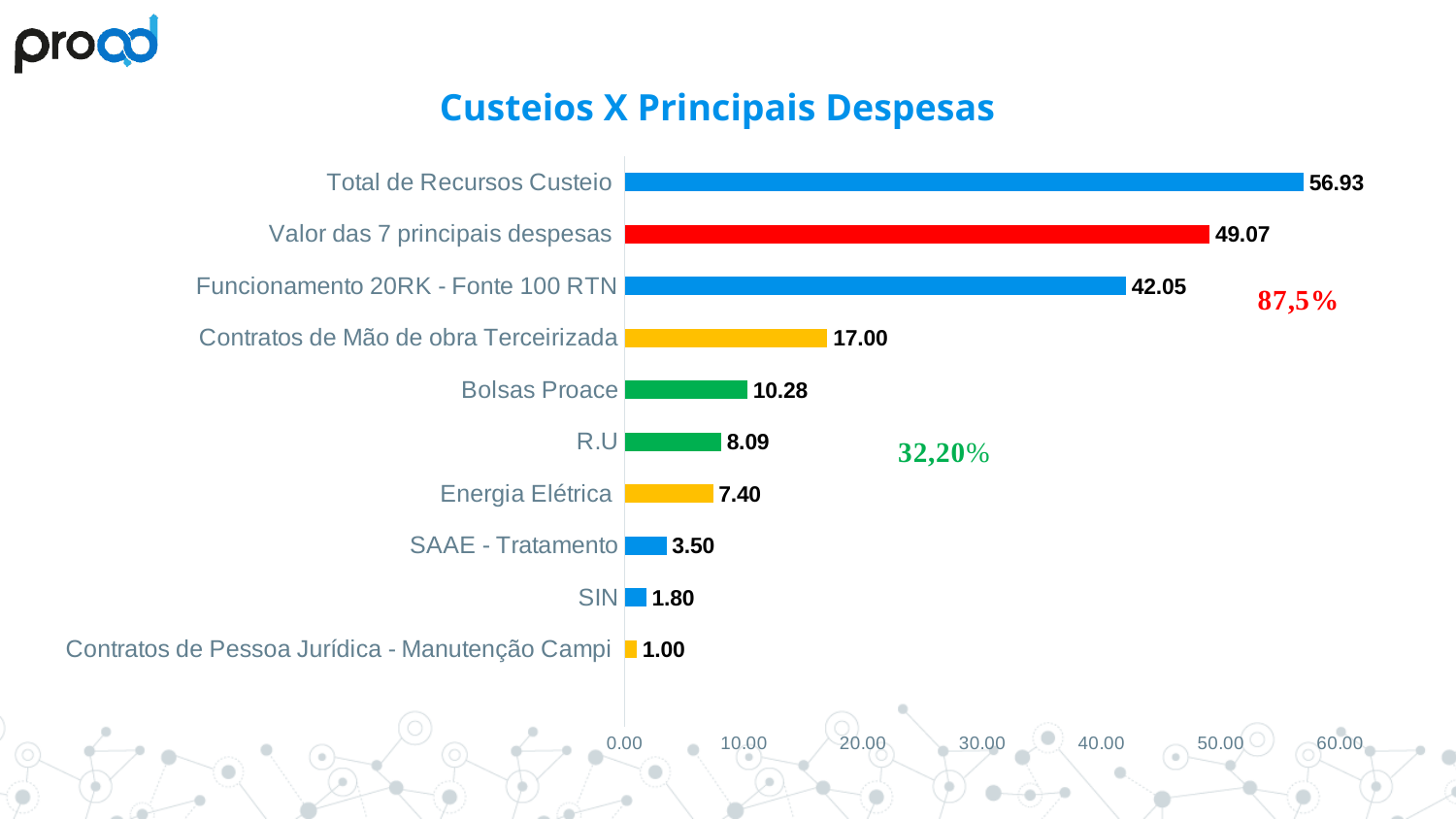
What is the value for Funcionamento 20RK - Fonte 100 RTN? 42.05 How many categories are shown in the chart? 10 Which category has the highest value? Total de Recursos Custeio What is the value for Total de Recursos Custeio? 56.93 What is the title of the chart? Custeios X Principais Despesas What is the difference between Total de Recursos Custeio and Valor das 7 principais despesas? 7.86 What is the value for Bolsas Proace? 10.28 Which category has the lowest value? Contratos de Pessoa Jurídica - Manutenção Campi Which is larger, R.U or Energia Elétrica? R.U Is the value for Contratos de Mão de obra Terceirizada greater or less than 20.00? less What is the value for SAAE - Tratamento? 3.50 What kind of chart is shown on the slide? bar chart